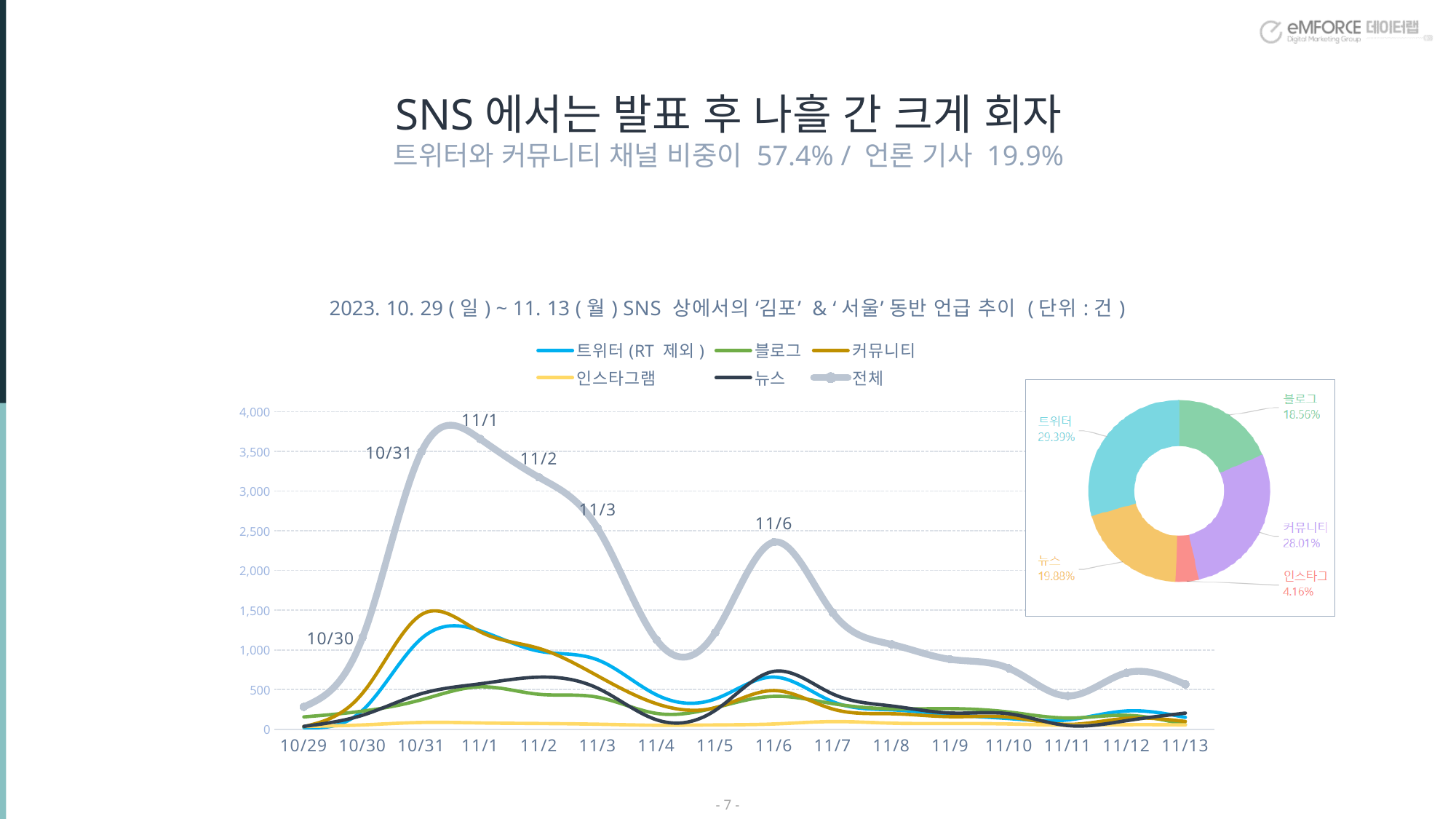
In the donut chart on the right, which category has the smallest share? 인스타그 In the line chart on the left, is the 전체 value on 10/29 greater or less than 500? less In the line chart on the left, is the 전체 value on 11/1 greater or less than 3,500? greater What kind of chart is the chart on the left showing the mention trend from 10/29 to 11/13? line chart In the line chart on the left, how many series does the legend list? 6 In the line chart on the left, is the 전체 value on 11/6 greater or less than 2,000? greater In the donut chart on the right, how many slices are there? 5 In the donut chart on the right, what is the share for 트위터? 29.39% In the donut chart on the right, what is the share for 커뮤니티? 28.01% In the donut chart on the right, which is larger, 블로그 or 뉴스? 뉴스 In the line chart on the left, how many dates are shown on the x axis? 16 In the line chart on the left, on which date does the 전체 line reach its highest value? 11/1